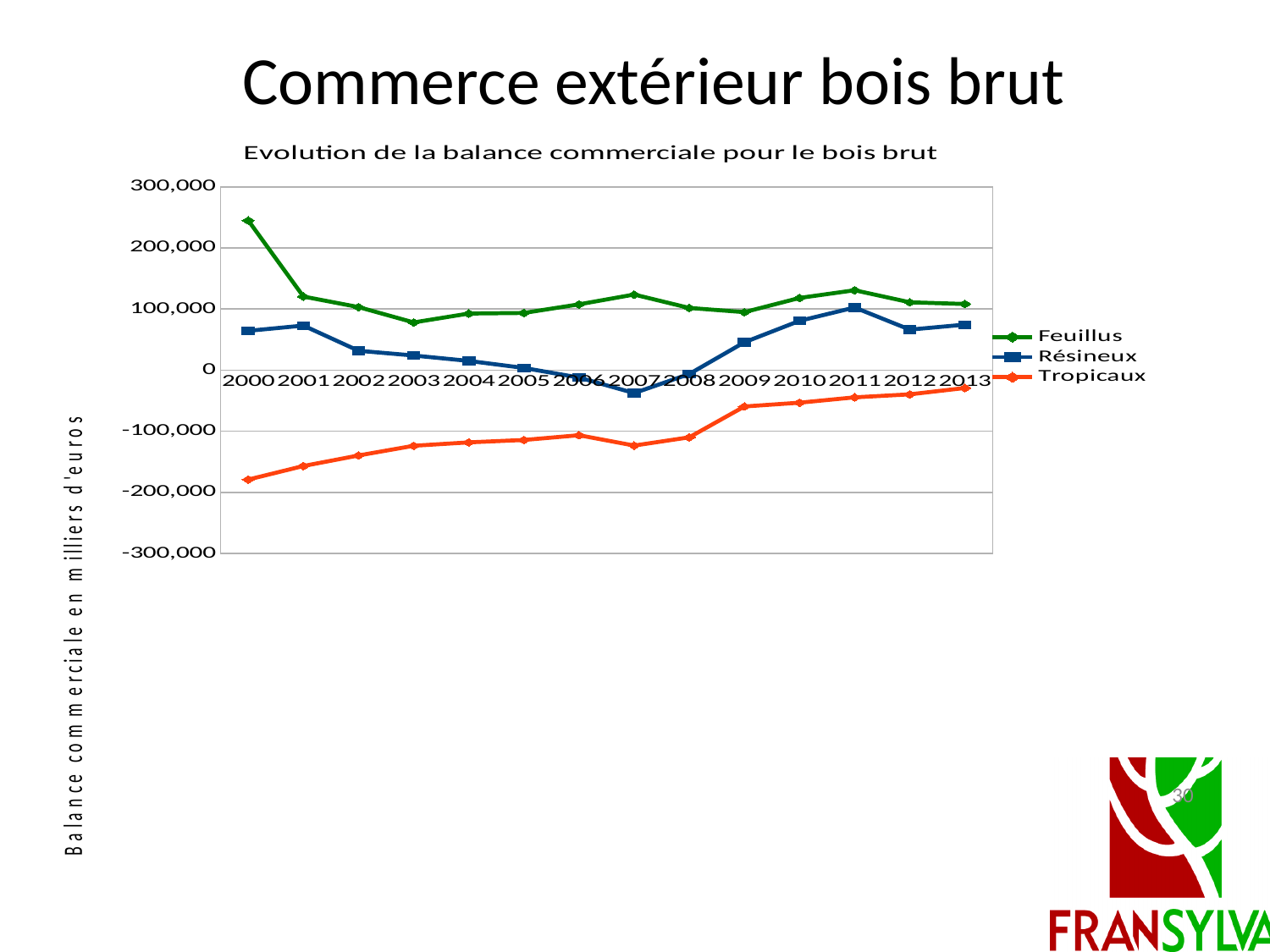
Does the Tropicaux series generally rise or fall from 2000 to 2013? rise Is the value for Résineux in 2003 greater or less than 100,000? less In which year does the Résineux series reach its lowest value? 2007 In which year does the Tropicaux series reach its lowest value? 2000 Is the value for Feuillus in 2000 greater or less than 200,000? greater How many series does the legend list? 3 What is the title of the chart? Evolution de la balance commerciale pour le bois brut In which year does the Feuillus series reach its highest value? 2000 Is the value for Tropicaux in 2000 greater or less than -100,000? less What is the label of the vertical axis? Balance commerciale en milliers d'euros What kind of chart is shown on the slide? line chart How many years are plotted along the x axis? 14